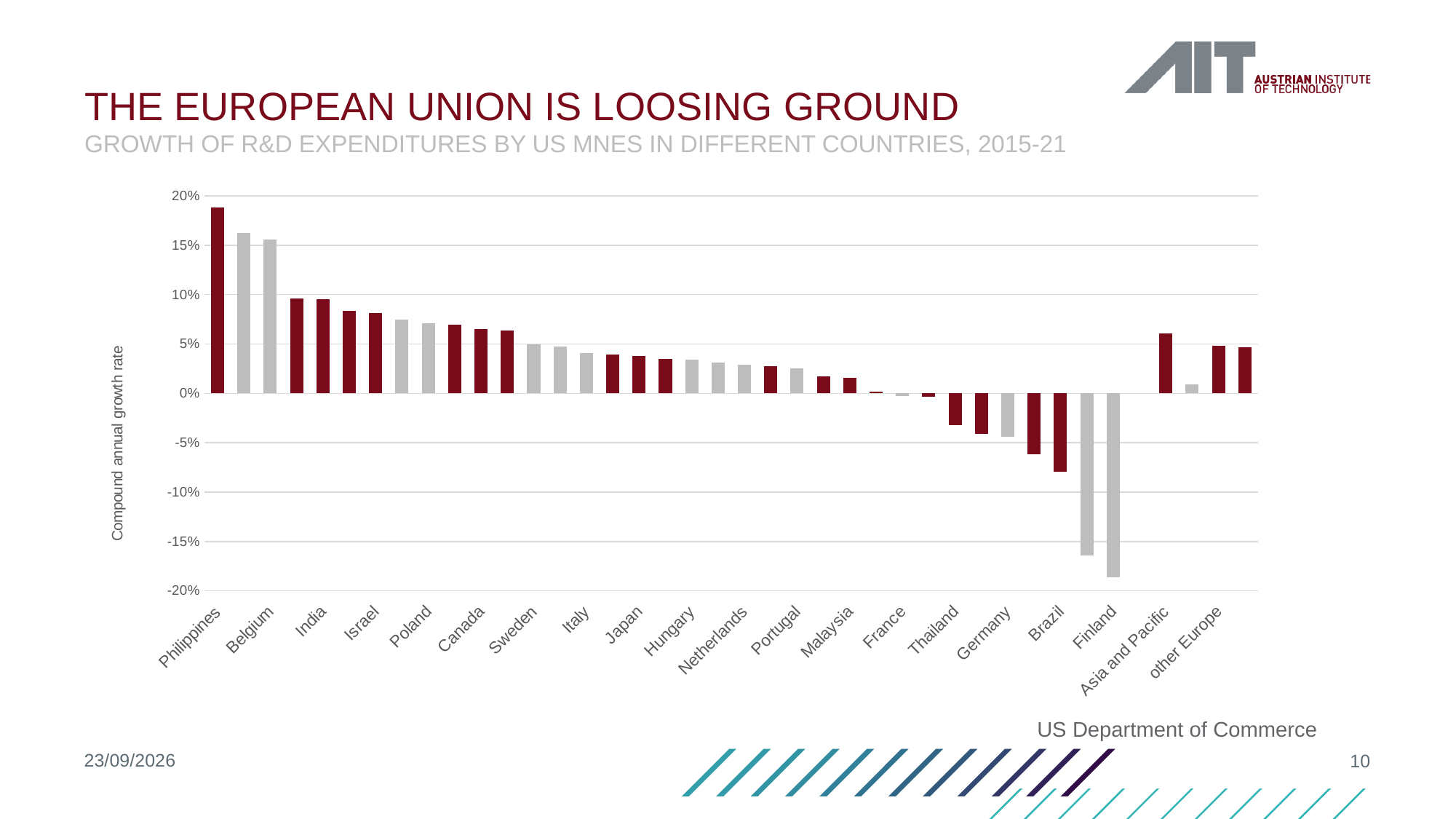
What is the subtitle describing the chart? Growth of R&D expenditures by US MNEs in different countries, 2015-21 Which category has the highest growth rate in the chart? Philippines What is the lowest value shown on the vertical axis? -20% Is the value for Philippines greater or less than 15%? greater How many category labels are shown on the x axis? 20 Is the value for Philippines greater or less than 20%? less Do the bar values generally rise or fall from left to right across the main group of countries? fall What is the label of the vertical axis? Compound annual growth rate What kind of chart is shown on the slide? bar chart